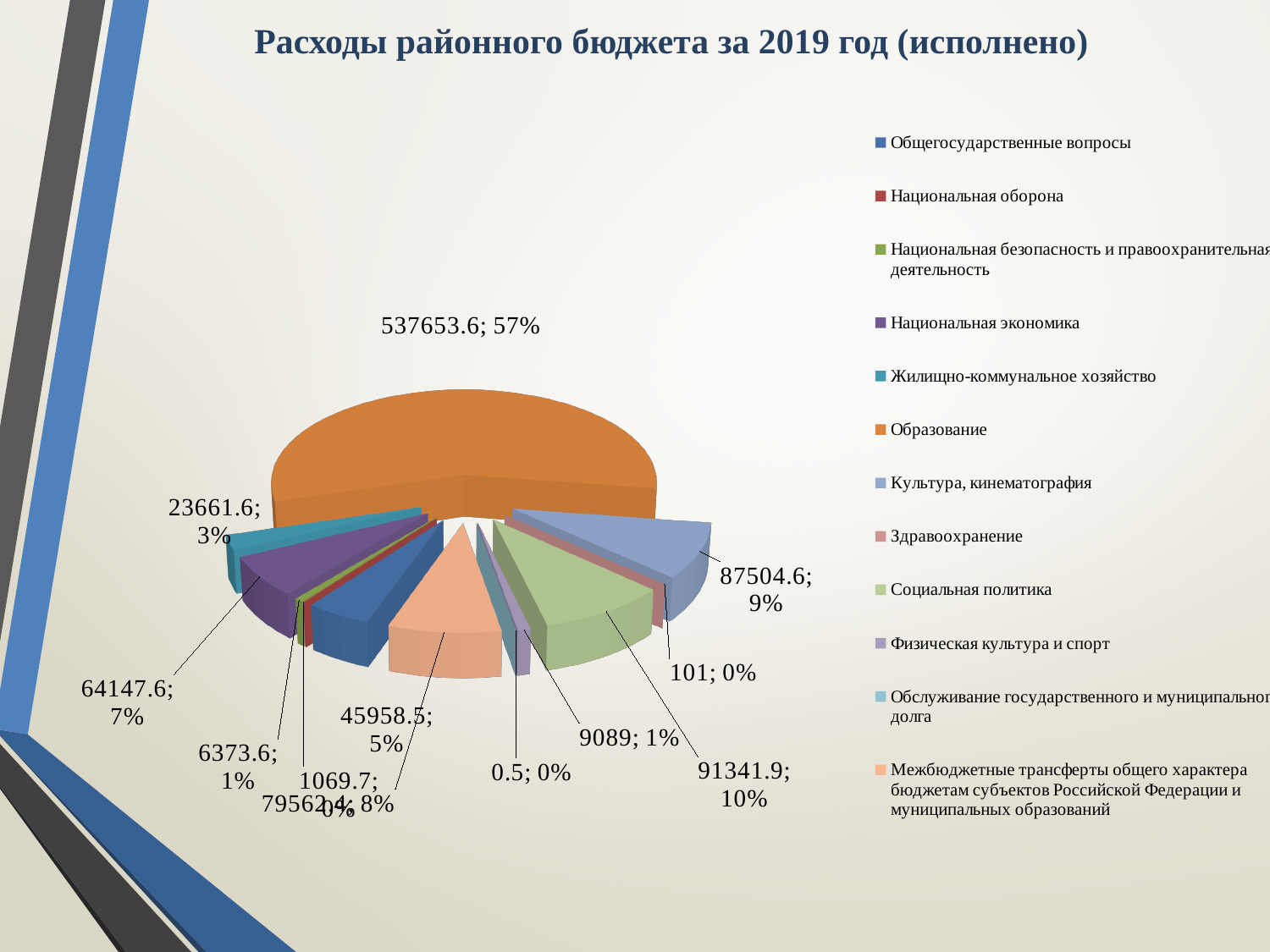
How many entries does the chart legend list? 12 What share of the pie does Национальная экономика take? 7% What value is shown for Образование? 537653.6 What kind of chart is shown on the slide? pie chart Which category has the largest slice of the pie? Образование What is the title of the chart? Расходы районного бюджета за 2019 год (исполнено) What share of the pie does Культура, кинематография take? 9% Which is larger, the value for Социальная политика or the value for Культура, кинематография? Социальная политика What is the difference between the values for Социальная политика and Культура, кинематография? 3837.3 What value is shown for Жилищно-коммунальное хозяйство? 23661.6 What value is shown for Социальная политика? 91341.9 What share of the pie does Образование take? 57%